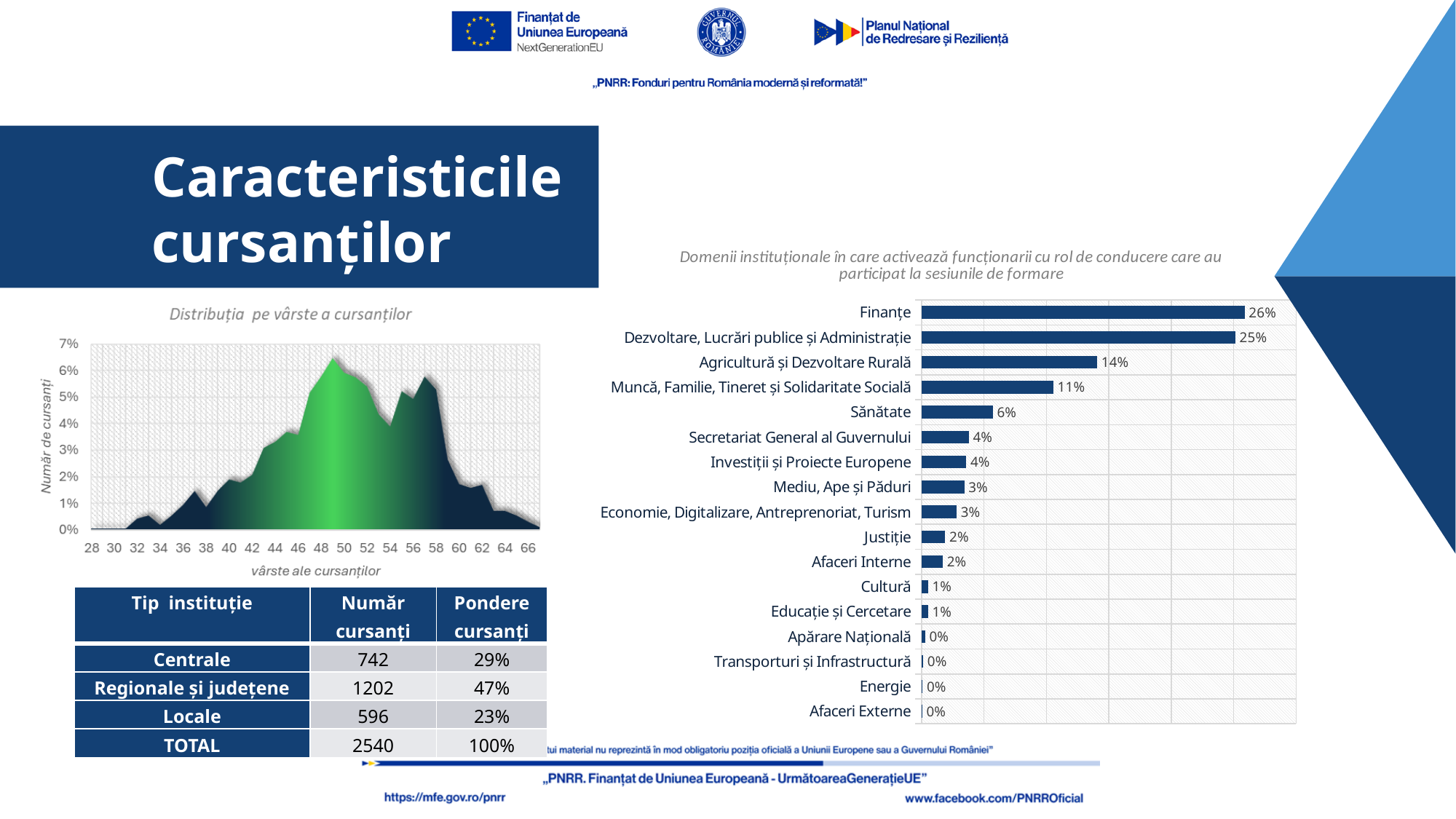
In the chart on the right, which is larger: Agricultură și Dezvoltare Rurală or Sănătate? Agricultură și Dezvoltare Rurală In the chart titled "Distribuția pe vârste a cursanților", is the value at age 28 greater or less than 1%? less In the chart titled "Domenii instituționale..." on the right, what is the value for Agricultură și Dezvoltare Rurală? 14% What is the y-axis label of the chart titled "Distribuția pe vârste a cursanților"? Număr de cursanți In the chart titled "Domenii instituționale în care activează funcționarii cu rol de conducere care au participat la sesiunile de formare", what is the value for Finanțe? 26% In the chart on the right, what is the value for Sănătate? 6% In the chart on the right, which category has the highest value? Finanțe In the chart on the right, what is the value for Justiție? 2% In the chart on the right, how many categories are shown? 17 In the chart on the right, what is the difference between Finanțe and Muncă, Familie, Tineret și Solidaritate Socială? 15% What kind of chart is the one on the right titled "Domenii instituționale..."? Bar chart